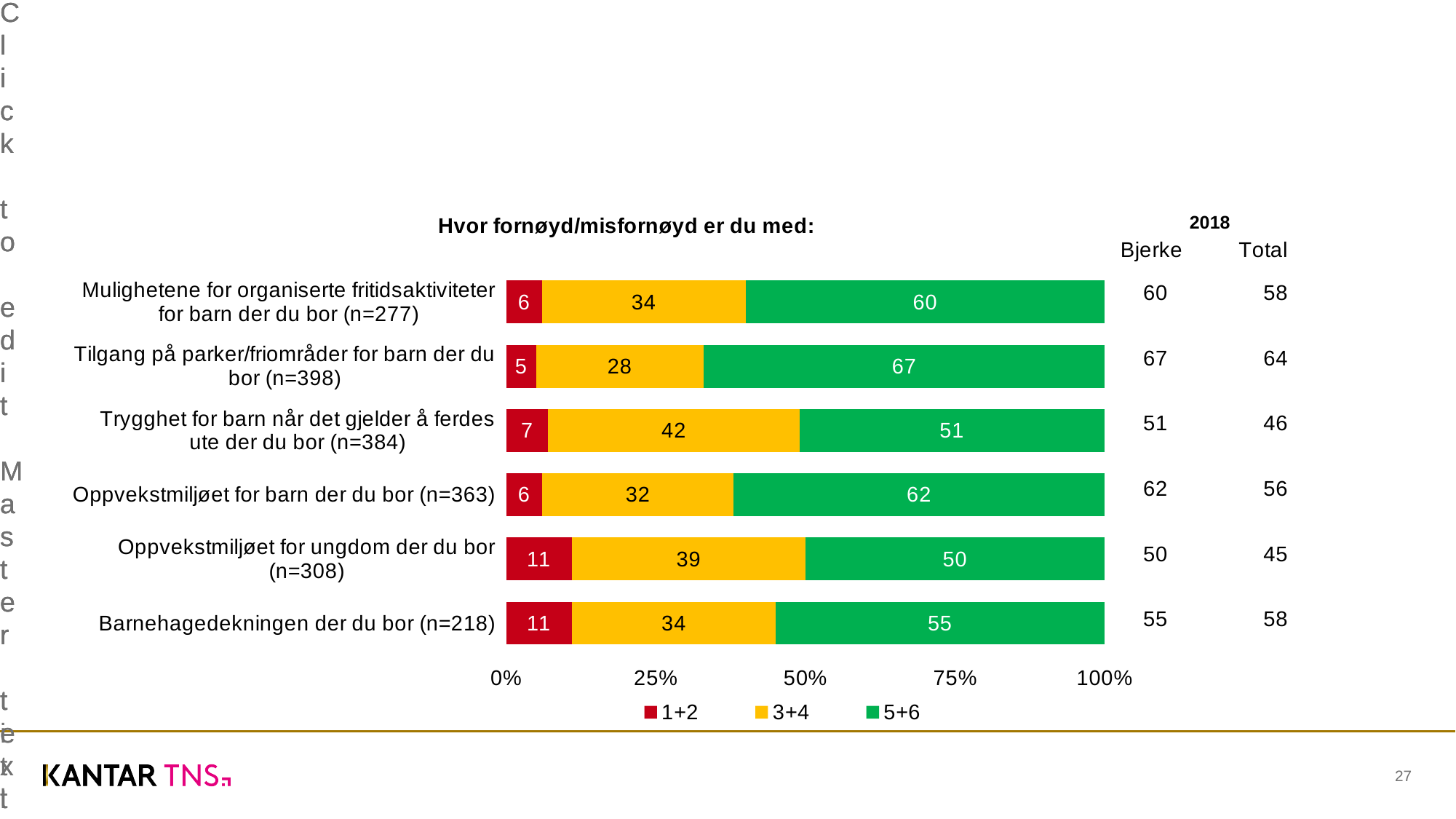
What is the 1+2 value for "Oppvekstmiljøet for ungdom der du bor (n=308)"? 11 What is the 5+6 value for "Tilgang på parker/friområder for barn der du bor (n=398)"? 67 How many series does the legend list? 3 Which category has the lowest 5+6 value? Oppvekstmiljøet for ungdom der du bor (n=308) What is the difference between the 5+6 values for "Oppvekstmiljøet for barn der du bor (n=363)" and "Oppvekstmiljøet for ungdom der du bor (n=308)"? 12 What type of chart is shown on the slide? Stacked bar chart Which category has the highest 5+6 value? Tilgang på parker/friområder for barn der du bor (n=398) What is the title of the chart? Hvor fornøyd/misfornøyd er du med: Which is larger: the 3+4 value for "Barnehagedekningen der du bor (n=218)" or the 3+4 value for "Tilgang på parker/friområder for barn der du bor (n=398)"? Barnehagedekningen der du bor (n=218) How many categories are plotted in the chart? 6 What is the total of the stacked bar for "Mulighetene for organiserte fritidsaktiviteter for barn der du bor (n=277)"? 100 What is the 3+4 value for "Trygghet for barn når det gjelder å ferdes ute der du bor (n=384)"? 42